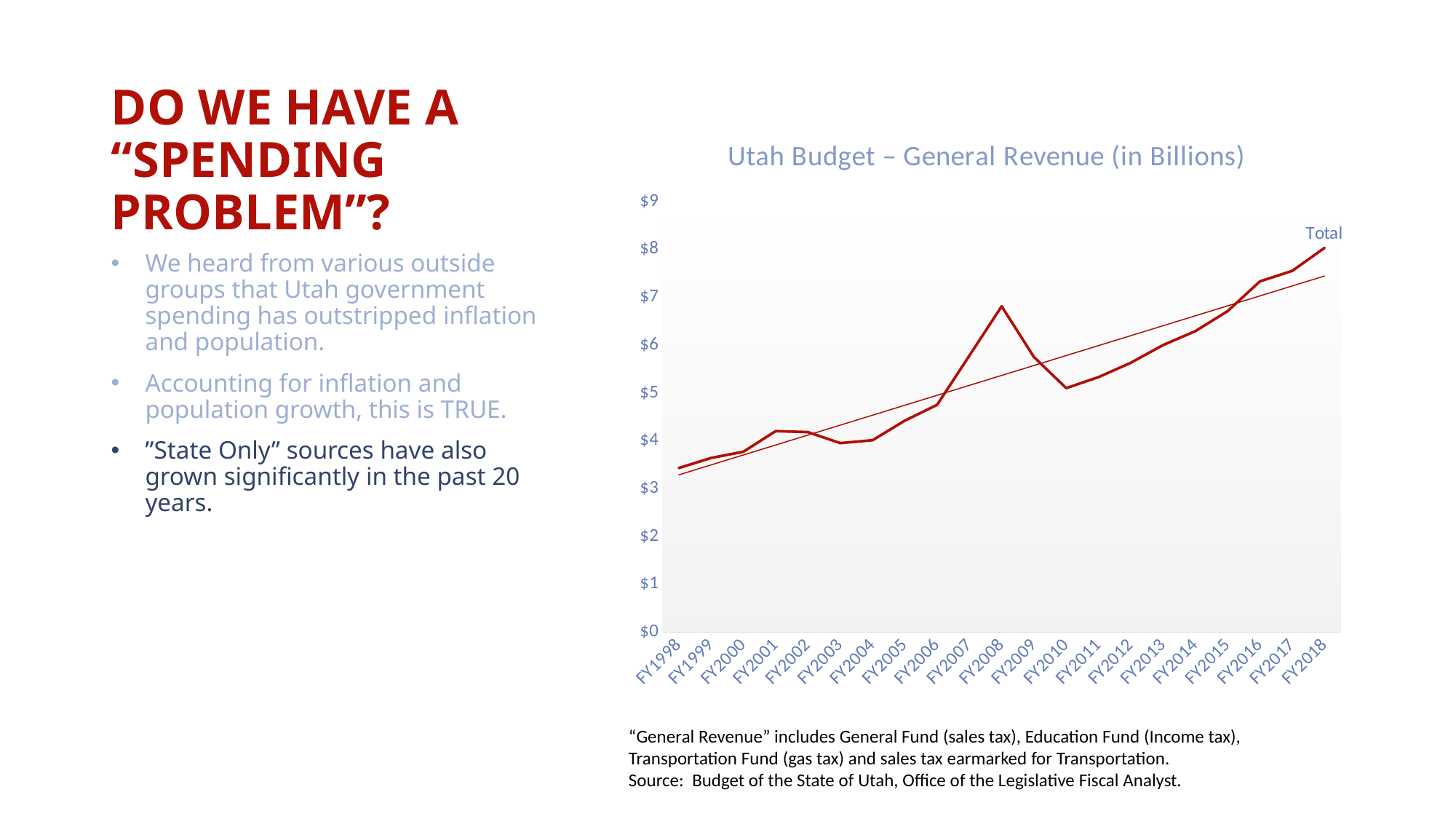
Is the value for FY2018 greater or less than $7? greater Overall, do the values rise or fall from FY1998 to FY2018? rise Which is larger, the value for FY2008 or the value for FY2010? FY2008 What label is shown next to the plotted line at the right end of the chart? Total Is the value for FY1998 greater or less than $4? less Which fiscal year has the highest general revenue in the chart? FY2018 Which fiscal year has the lowest general revenue in the chart? FY1998 What kind of chart is shown on the slide? line chart What is the title of the chart? Utah Budget – General Revenue (in Billions) How many fiscal years are plotted along the x axis of the chart? 21 Is the value for FY2010 greater or less than $6? less